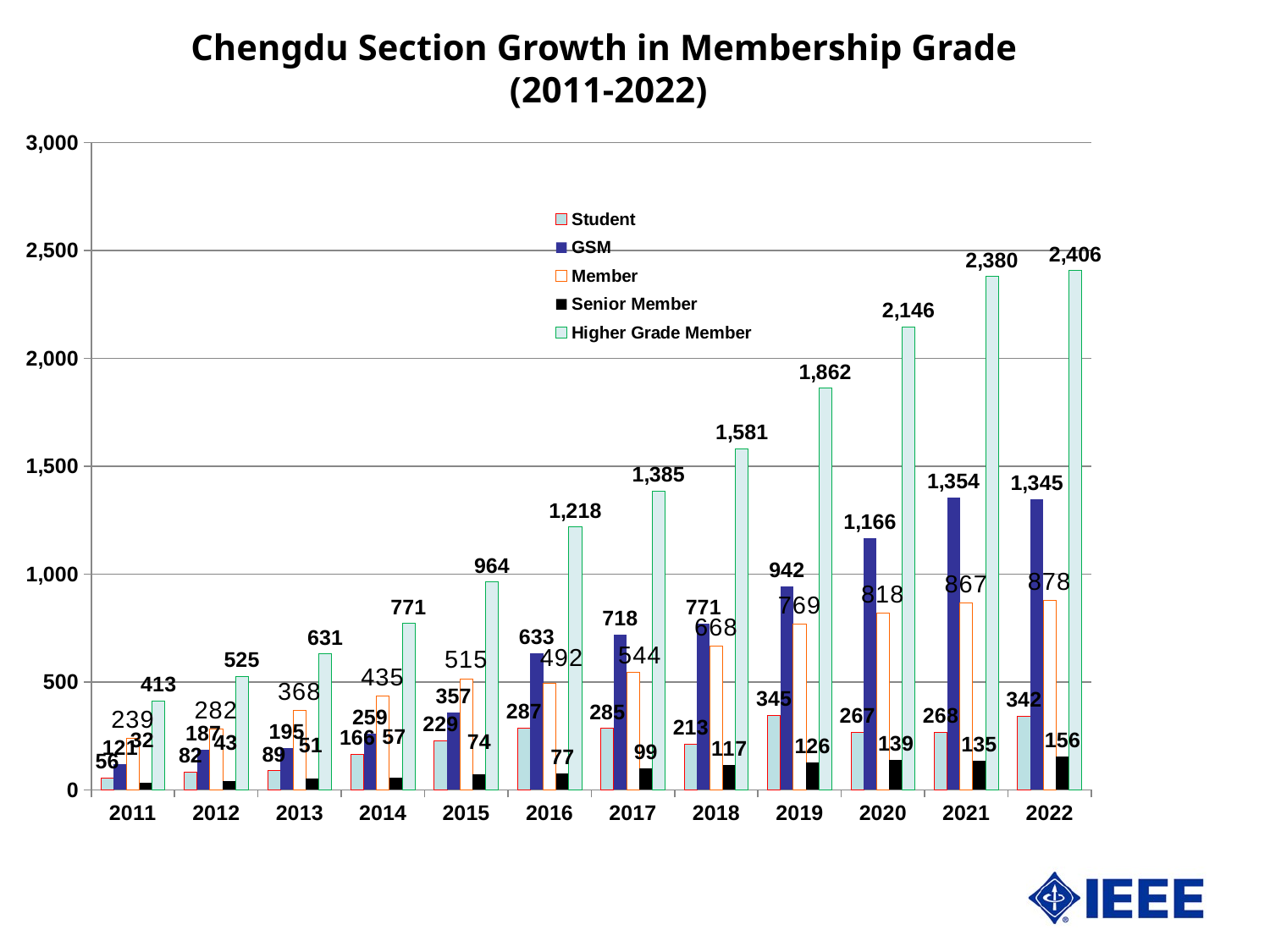
Which year has the lowest Higher Grade Member value? 2011 What kind of chart is shown on the slide? Bar chart Which is larger, the GSM value for 2021 or the GSM value for 2022? 2021 Does the Higher Grade Member value rise or fall from 2011 to 2022? Rise What is the GSM value for 2020? 1,166 How many series does the legend list? 5 Which year has the highest Student value? 2019 What is the difference between the Higher Grade Member values for 2021 and 2020? 234 How many years are shown on the x axis? 12 What is the Higher Grade Member value for 2022? 2,406 What is the Member value for 2018? 668 What is the Senior Member value for 2019? 126